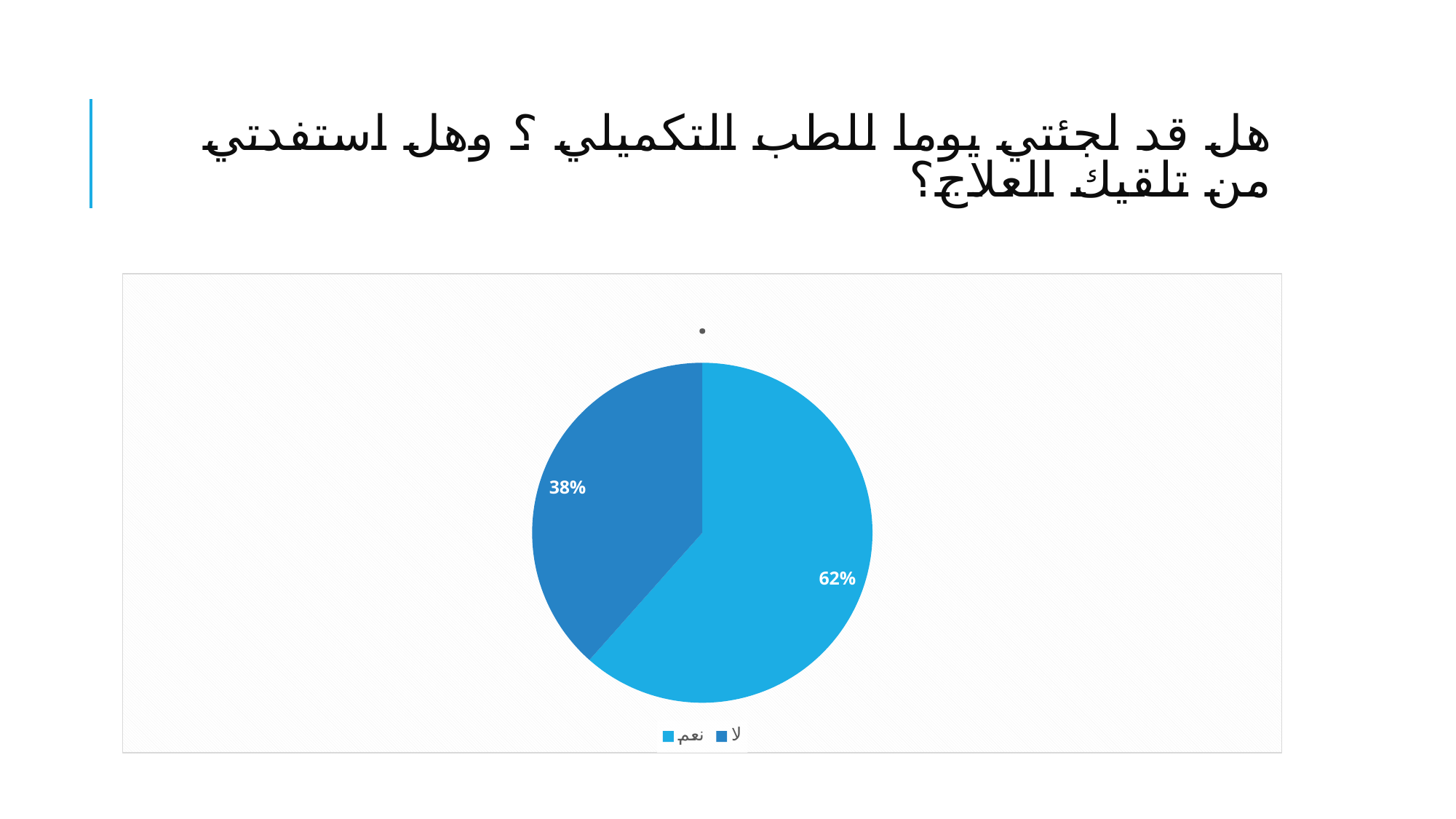
Which legend entry is shown in the darker blue colour? لا Which is larger, the "نعم" slice or the "لا" slice? نعم What share of the pie does the "لا" slice represent? 38% How many slices does the pie chart have? 2 How many entries does the legend list? 2 What is the difference in percentage points between the "نعم" slice and the "لا" slice? 24 Is the share of the "لا" slice greater or less than 50%? less What share of the pie does the "نعم" slice represent? 62% What kind of chart is shown on the slide? pie chart What are the two legend entries of the pie chart? نعم and لا Which slice is the smallest in the pie chart? لا Which slice is the largest in the pie chart? نعم